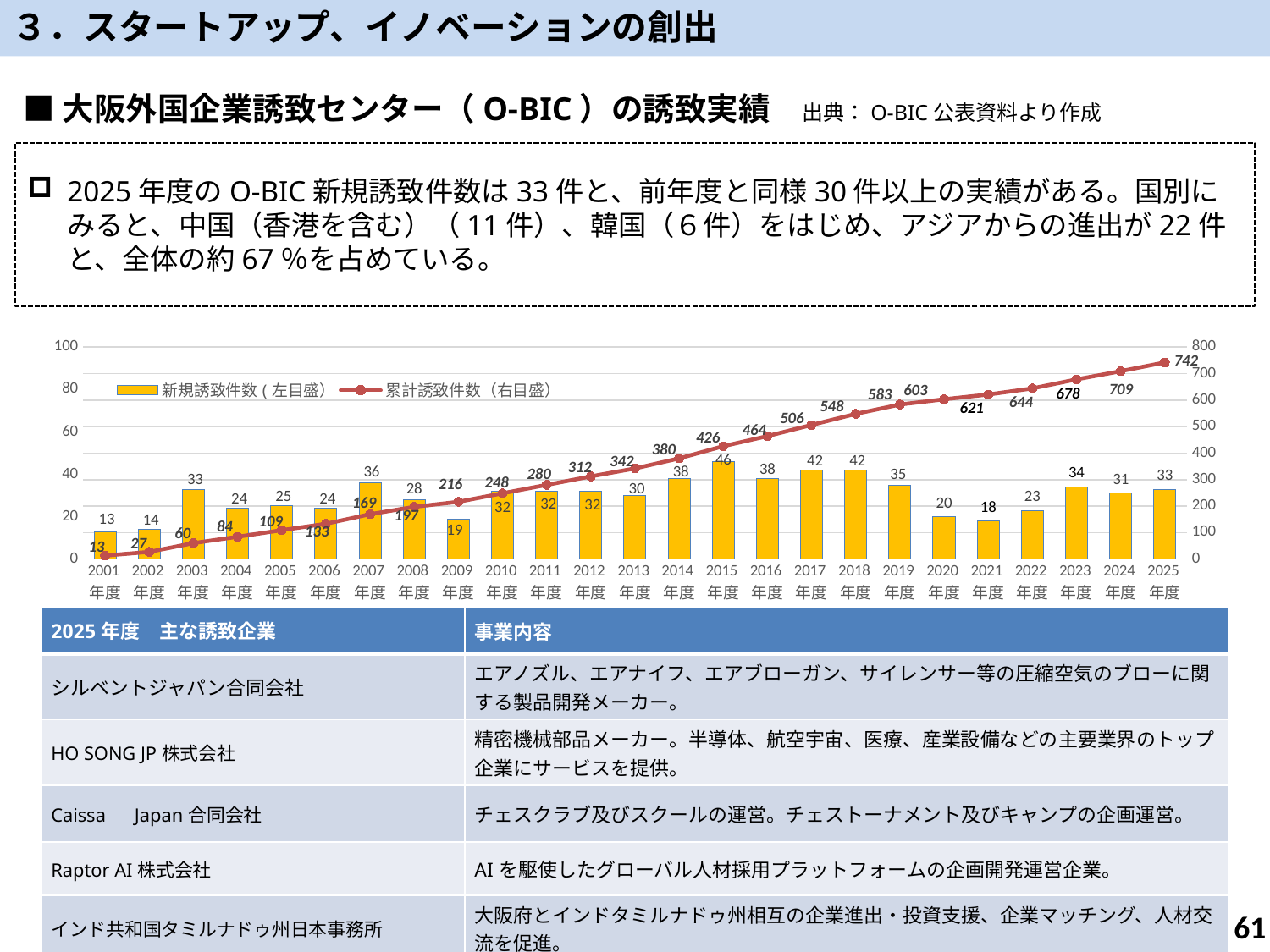
What is the 新規誘致件数 (new attraction count) for 2025年度? 33 What colour are the bars for 新規誘致件数 in the chart? yellow/orange Does the 累計誘致件数 line rise or fall from 2001年度 to 2025年度? rise What is the 累計誘致件数 (cumulative count) for 2025年度? 742 How many series does the chart legend list? 2 Which is larger, the 新規誘致件数 for 2023年度 or for 2024年度? 2023年度 Which fiscal year has the highest 新規誘致件数? 2015年度 What is the 累計誘致件数 for 2020年度? 603 What is the difference between the 新規誘致件数 for 2015年度 and 2021年度? 28 How many fiscal years are shown on the x axis of the chart? 25 What kind of chart is used to show the 新規誘致件数 series? bar chart Which fiscal year has the lowest 新規誘致件数? 2001年度